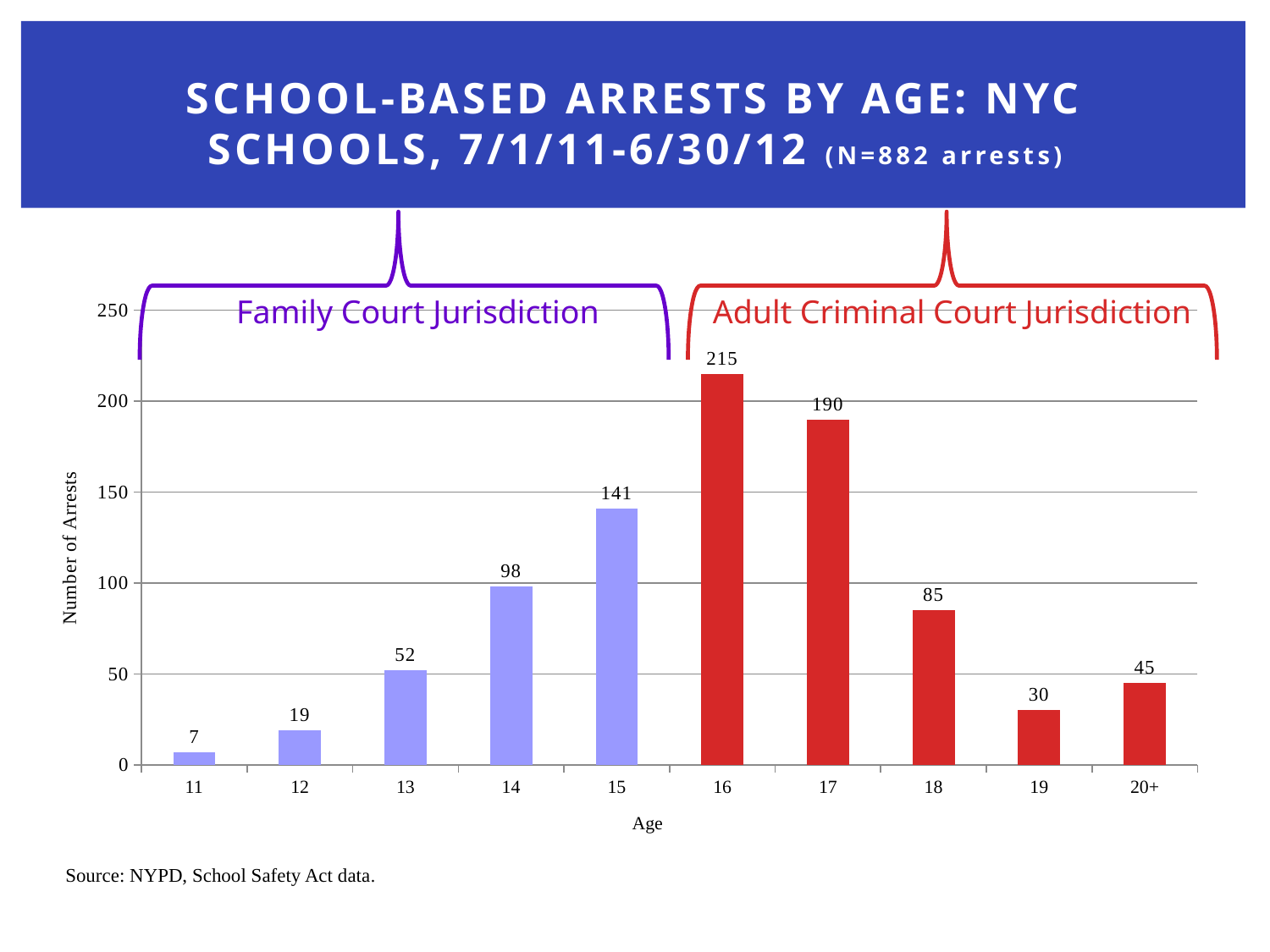
Do the number of arrests rise or fall from age 11 to age 16? Rise What kind of chart is shown on the slide? Bar chart How many age categories are shown on the x axis? 10 Which age group has the lowest number of arrests? 11 How many arrests were there for age 16? 215 Which age group has the highest number of arrests? 16 How many arrests were there for age 20+? 45 What is the difference in arrests between age 15 and age 13? 89 What is the difference in arrests between age 16 and age 17? 25 Which has more arrests, age 18 or age 19? 18 How many arrests were there for age 14? 98 Which jurisdiction label covers the ages 16 through 20+? Adult Criminal Court Jurisdiction